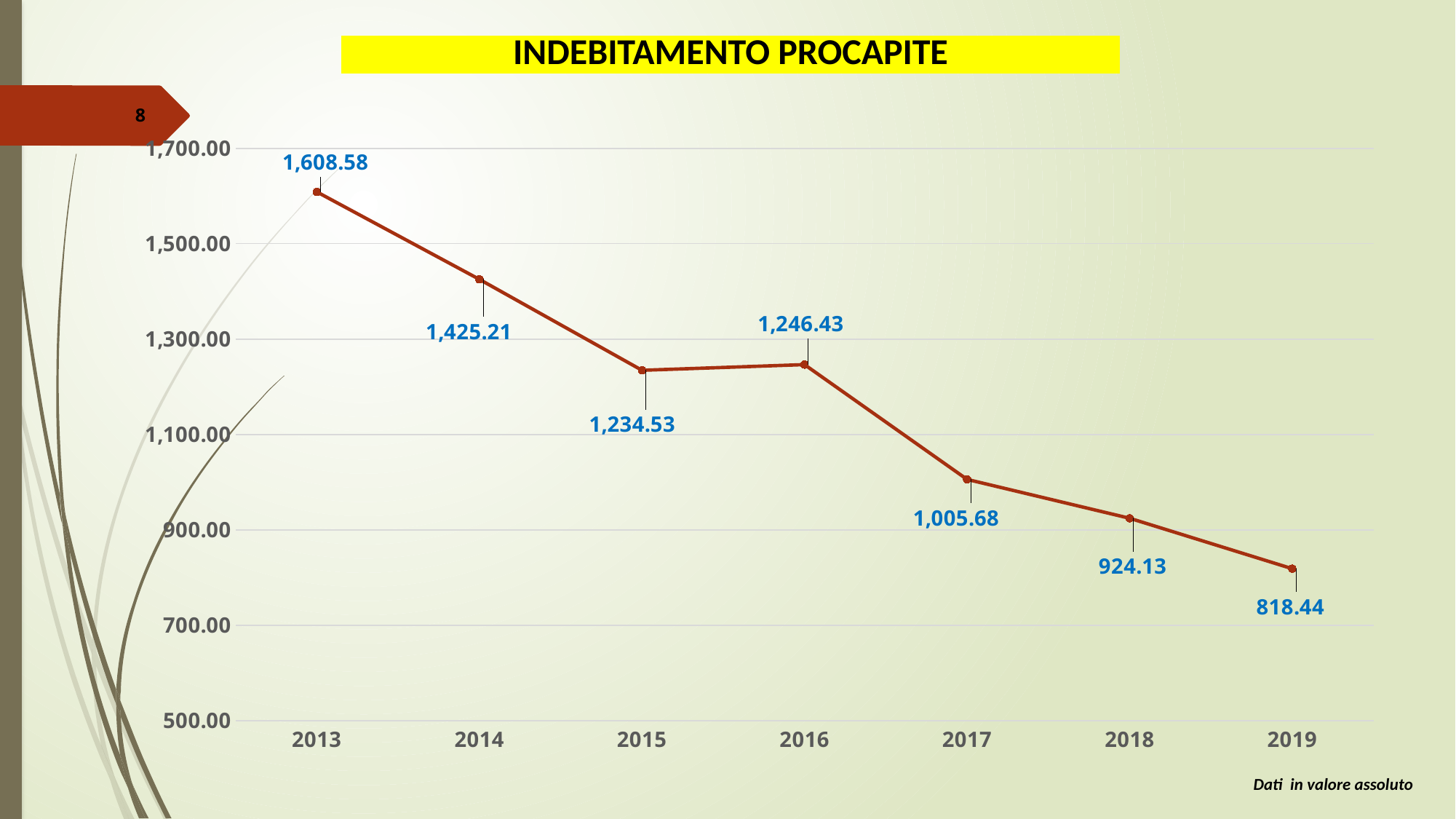
Which is larger, the value for 2015 or the value for 2016? 2016 What is the difference between the values for 2018 and 2019? 105.69 What is the value for 2019? 818.44 Which year has the lowest value? 2019 What is the difference between the values for 2013 and 2014? 183.37 Do the values generally rise or fall from 2013 to 2019? fall How many years are plotted on the chart? 7 What is the value for 2017? 1,005.68 What kind of chart is shown on the slide? line chart Is the value for 2018 greater or less than 900.00? greater Which year has the highest value? 2013 What is the value for 2013? 1,608.58